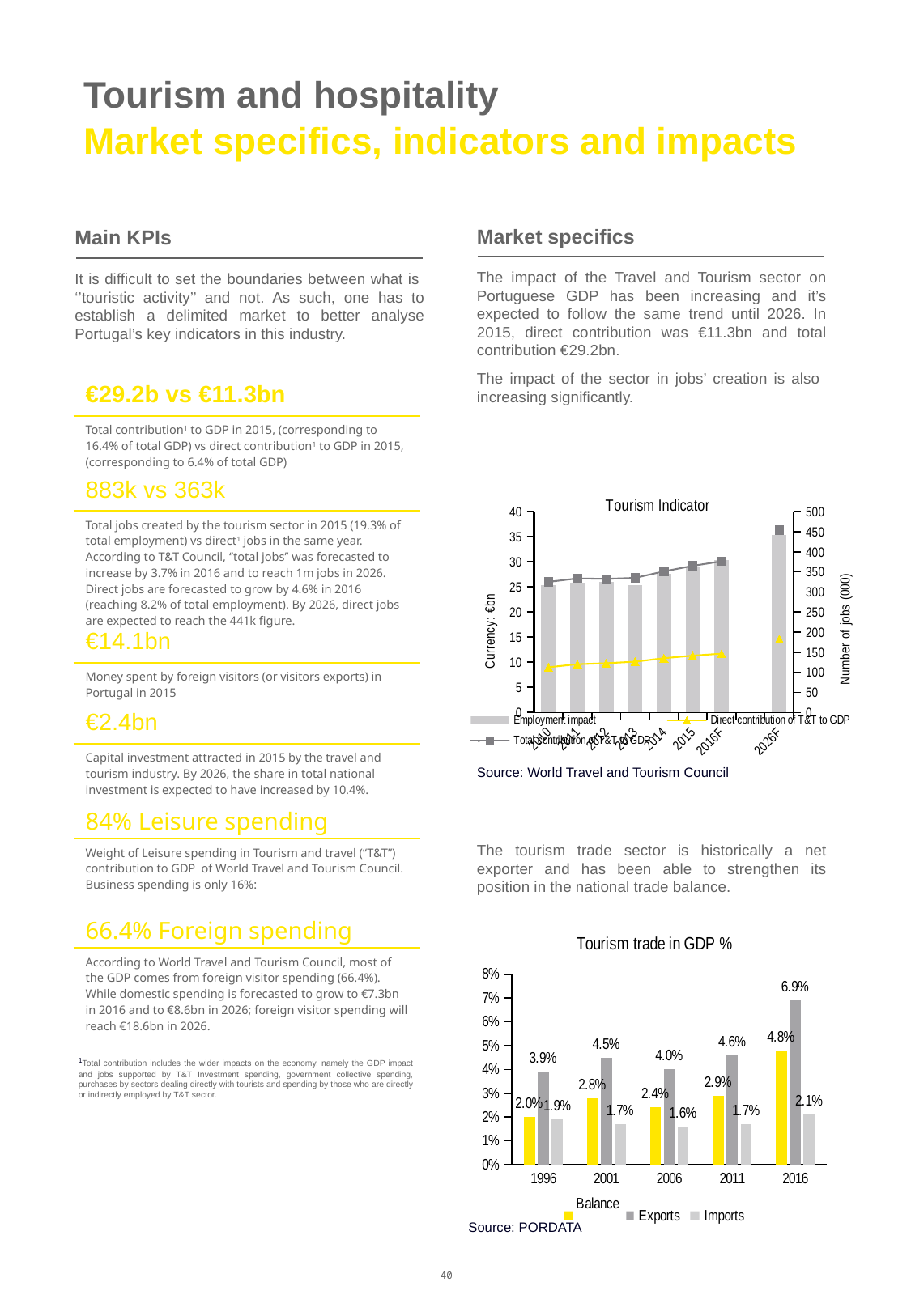
In the 'Tourism trade in GDP %' chart, which year has the lowest Imports value? 2006 In the 'Tourism Indicator' chart, how many years are shown on the x axis? 8 In the 'Tourism trade in GDP %' chart, how many series does the legend list? 3 In the 'Tourism trade in GDP %' chart, is the Balance value larger in 2011 or in 2006? 2011 In the 'Tourism trade in GDP %' chart, what is the Balance value for 2001? 2.8% What kind of chart is the 'Tourism trade in GDP %' chart? bar chart In the 'Tourism Indicator' chart, is the Employment impact value for 2026F greater or less than 400 on the right axis? greater In the 'Tourism trade in GDP %' chart, what is the Exports value for 2016? 6.9% In the 'Tourism trade in GDP %' chart, what is the Imports value for 2006? 1.6% In the 'Tourism trade in GDP %' chart, which year has the highest Exports value? 2016 In the 'Tourism trade in GDP %' chart, what is the difference between Exports and Imports in 2016? 4.8% In the 'Tourism trade in GDP %' chart, does the Balance value rise or fall from 1996 to 2016? rise